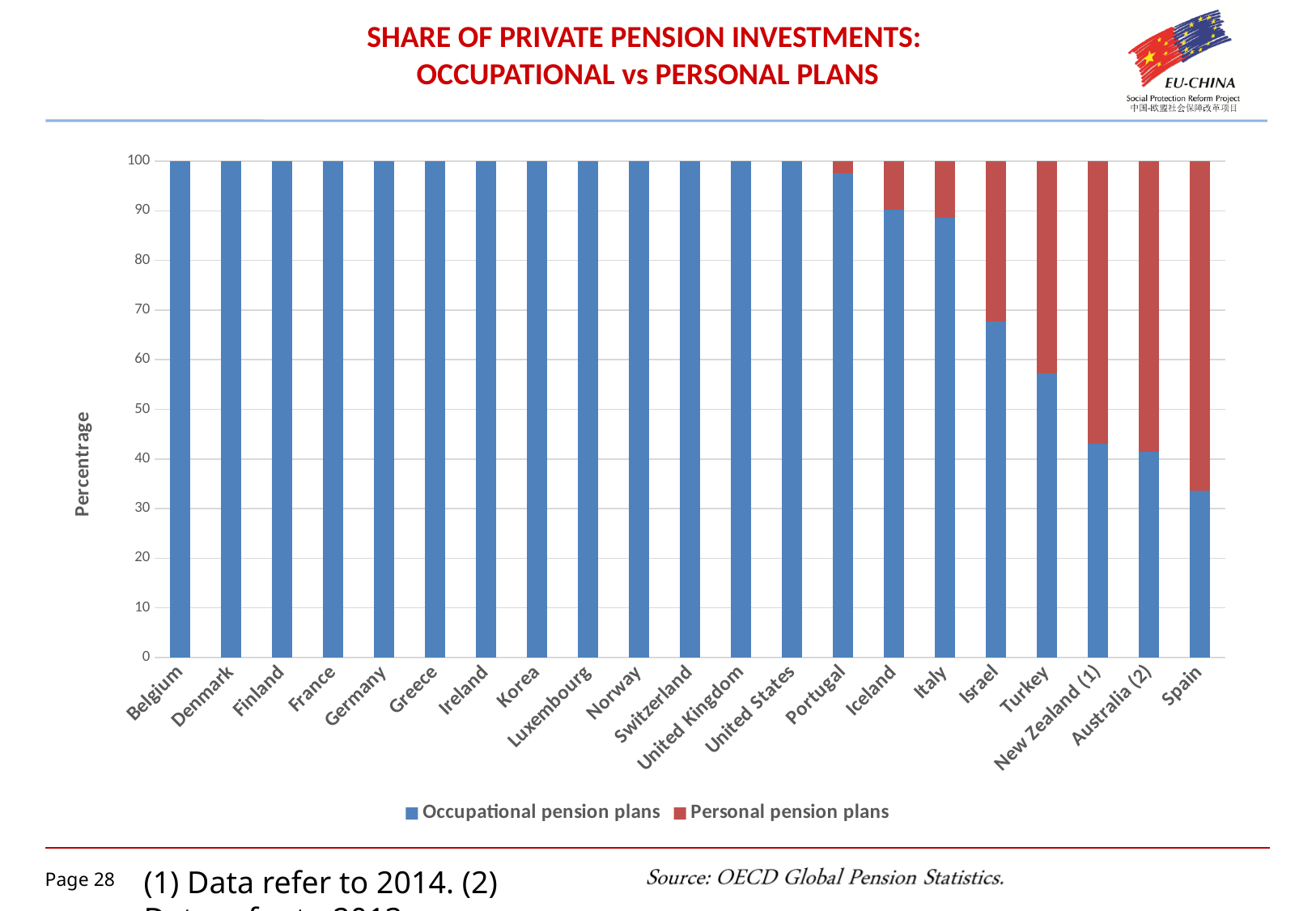
What is the occupational pension plans share for Belgium? 100 Is the occupational pension plans share for Israel greater or less than 60? greater Is the occupational pension plans share for Spain greater or less than 40? less Is the occupational pension plans share for New Zealand (1) greater or less than 50? less Which has a larger occupational pension plans share, Israel or Turkey? Israel How many countries are shown on the x axis? 21 How many series does the legend list? 2 Does the occupational pension plans share rise or fall moving from left to right along the x axis? Fall What kind of chart is shown on the slide? Stacked bar chart Which country has the lowest share of occupational pension plans? Spain Which country has the highest share of personal pension plans? Spain